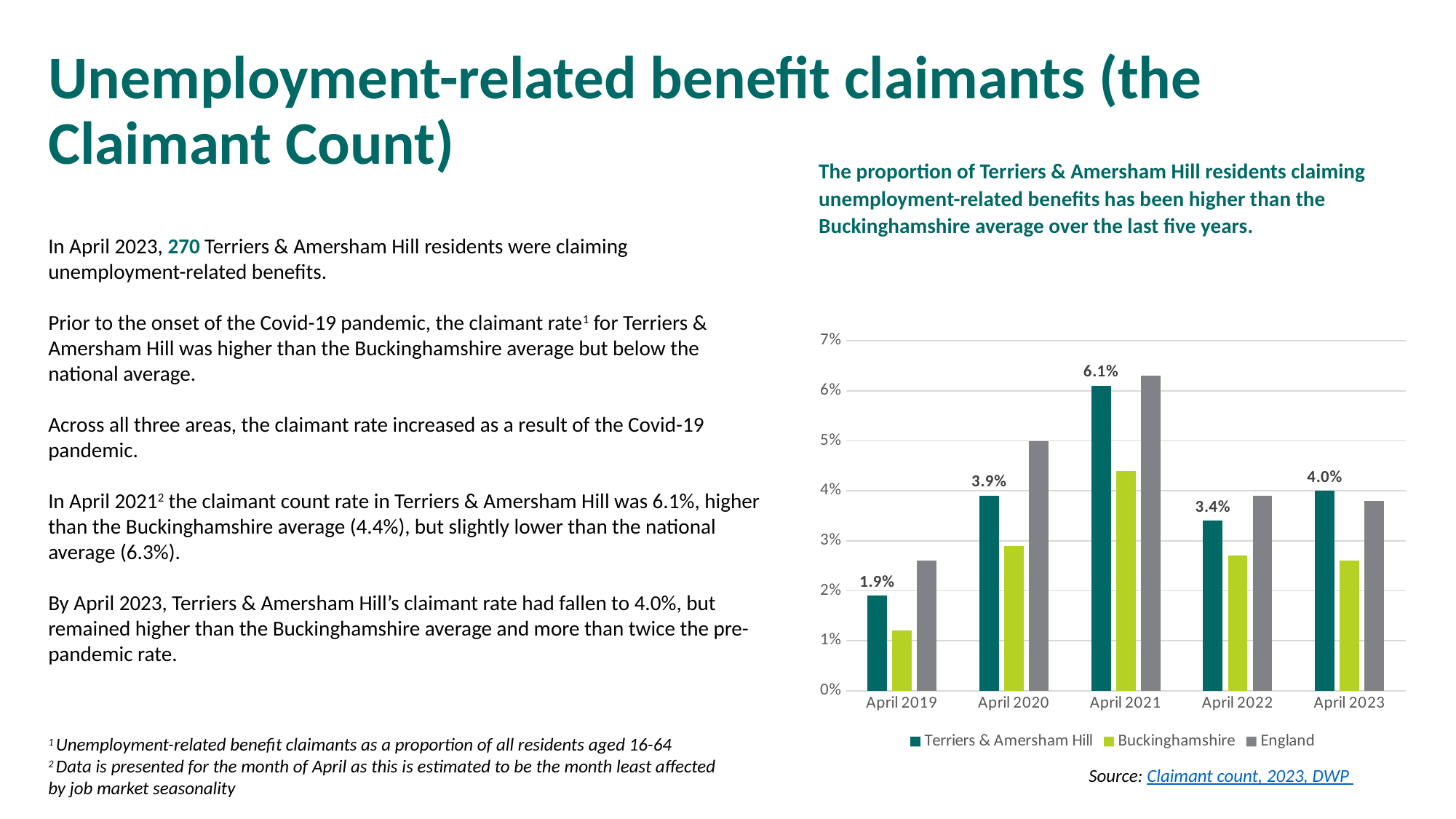
How many series does the chart legend list? 3 What type of chart is used to show the claimant rates? Bar chart What was the claimant rate for Terriers & Amersham Hill in April 2021? 6.1% In which year was the Terriers & Amersham Hill claimant rate highest? April 2021 Is the Buckinghamshire claimant rate in April 2021 greater or less than 4%? greater Is the England claimant rate in April 2019 greater or less than 3%? less What was the claimant rate for Terriers & Amersham Hill in April 2023? 4.0% How many years are shown on the x axis of the chart? 5 By how many percentage points did the Terriers & Amersham Hill claimant rate fall between April 2021 and April 2023? 2.1 percentage points Which was higher for Terriers & Amersham Hill: the claimant rate in April 2020 or in April 2022? April 2020 What was the claimant rate for Terriers & Amersham Hill in April 2019? 1.9% In which year was the Terriers & Amersham Hill claimant rate lowest? April 2019